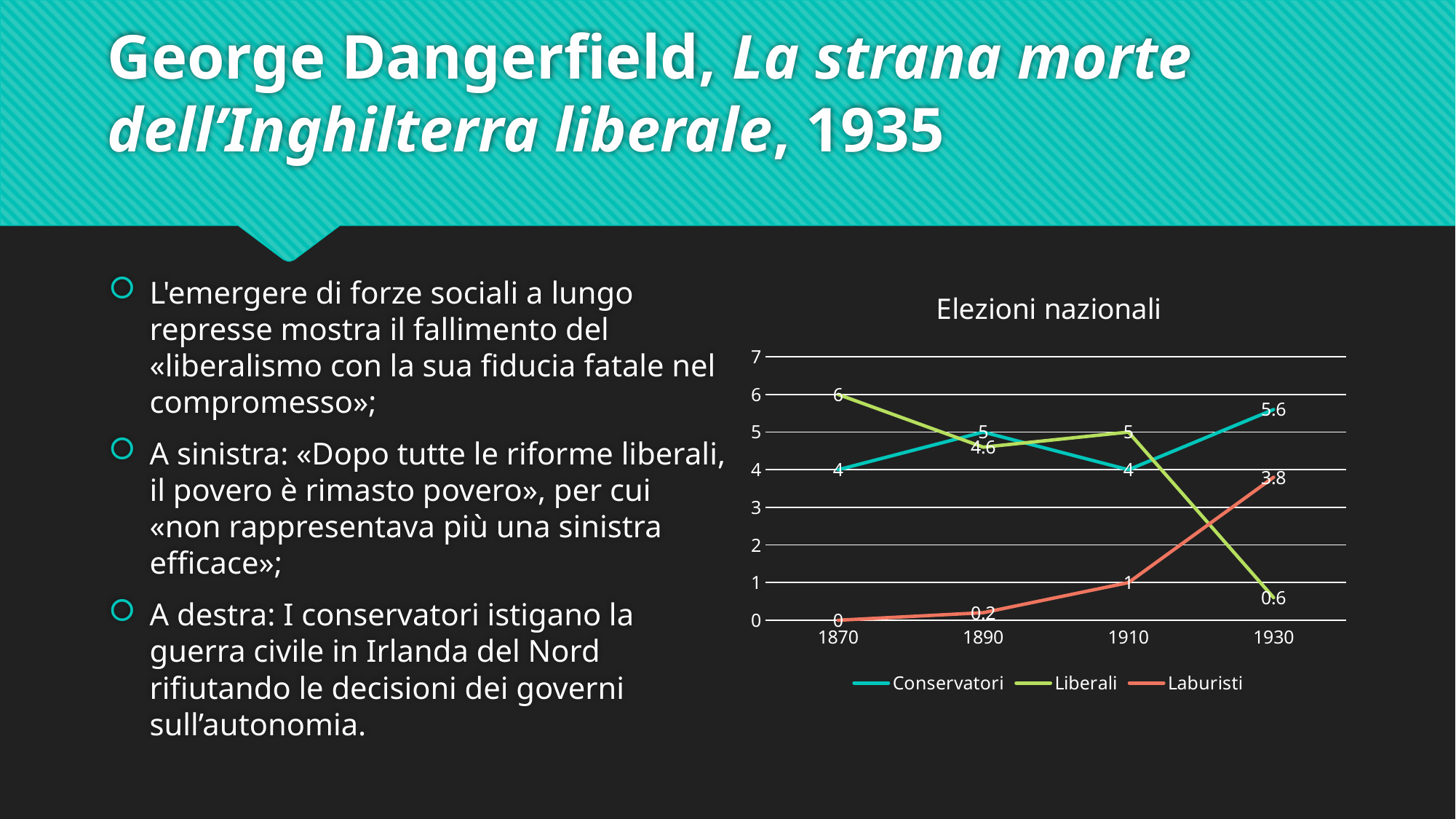
What is the value for Laburisti in 1910? 1 How many points are plotted along the x axis for each series? 4 In which year is the Liberali value lowest? 1930 What is the value for Liberali in 1870? 6 What is the title of the chart? Elezioni nazionali Do the Laburisti values rise or fall from 1870 to 1930? rise What is the value for Conservatori in 1930? 5.6 What kind of chart is shown on the slide? line chart Which is larger in 1910, the Liberali value or the Conservatori value? Liberali How many series does the legend list? 3 What is the difference between the Liberali value in 1870 and in 1930? 5.4 In which year is the Laburisti value highest? 1930